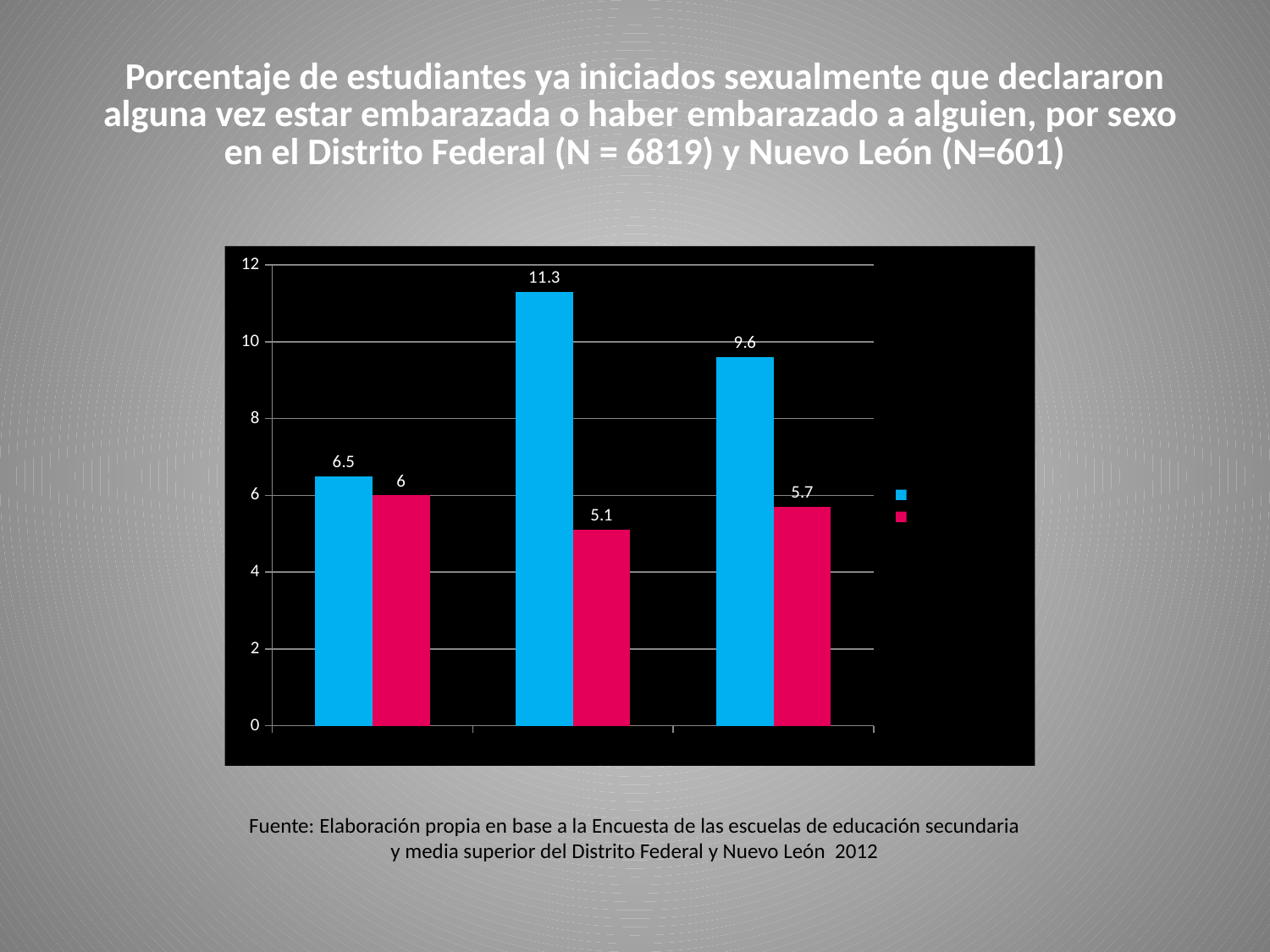
What colours are used for the two series in the chart? blue and pink What is the value of the pink bar in the third group? 5.7 What is the value of the blue bar in the second group? 11.3 How many series does the legend list? 2 Which bar has the lowest value on the chart? the pink bar in the second group (5.1) What is the value of the pink bar in the first group? 6 How many groups of bars are plotted along the x axis? 3 Which bar has the highest value on the chart? the blue bar in the second group (11.3) What is the value of the blue bar in the first group? 6.5 In the third group, which bar is larger, the blue one or the pink one? the blue one What is the difference between the blue and pink bars in the second group? 6.2 What kind of chart is shown on the slide? bar chart